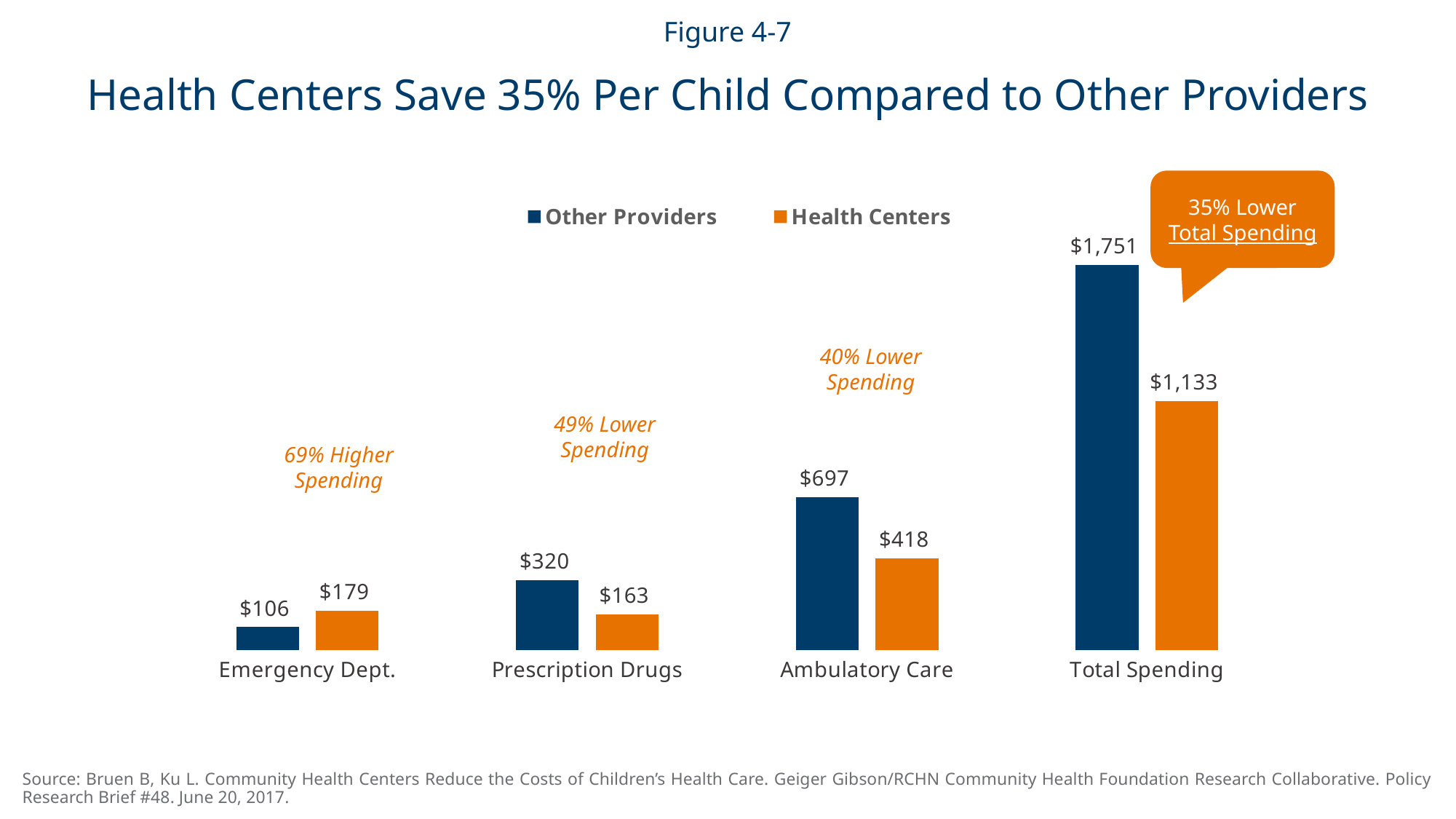
What is the value for Health Centers in the Total Spending category? $1,133 Which category has the lowest value for Health Centers? Emergency Dept. In the Emergency Dept. category, which series has the larger value, Other Providers or Health Centers? Health Centers What is the value for Health Centers in the Prescription Drugs category? $163 What is the value for Other Providers in the Ambulatory Care category? $697 What is the difference between Other Providers and Health Centers in the Ambulatory Care category? $279 What is the difference between Other Providers and Health Centers in the Total Spending category? $618 What is the value for Other Providers in the Emergency Dept. category? $106 How many categories are shown on the x axis? 4 Which category has the highest value for Other Providers? Total Spending What kind of chart is shown on the slide? Bar chart How many series does the legend list? 2